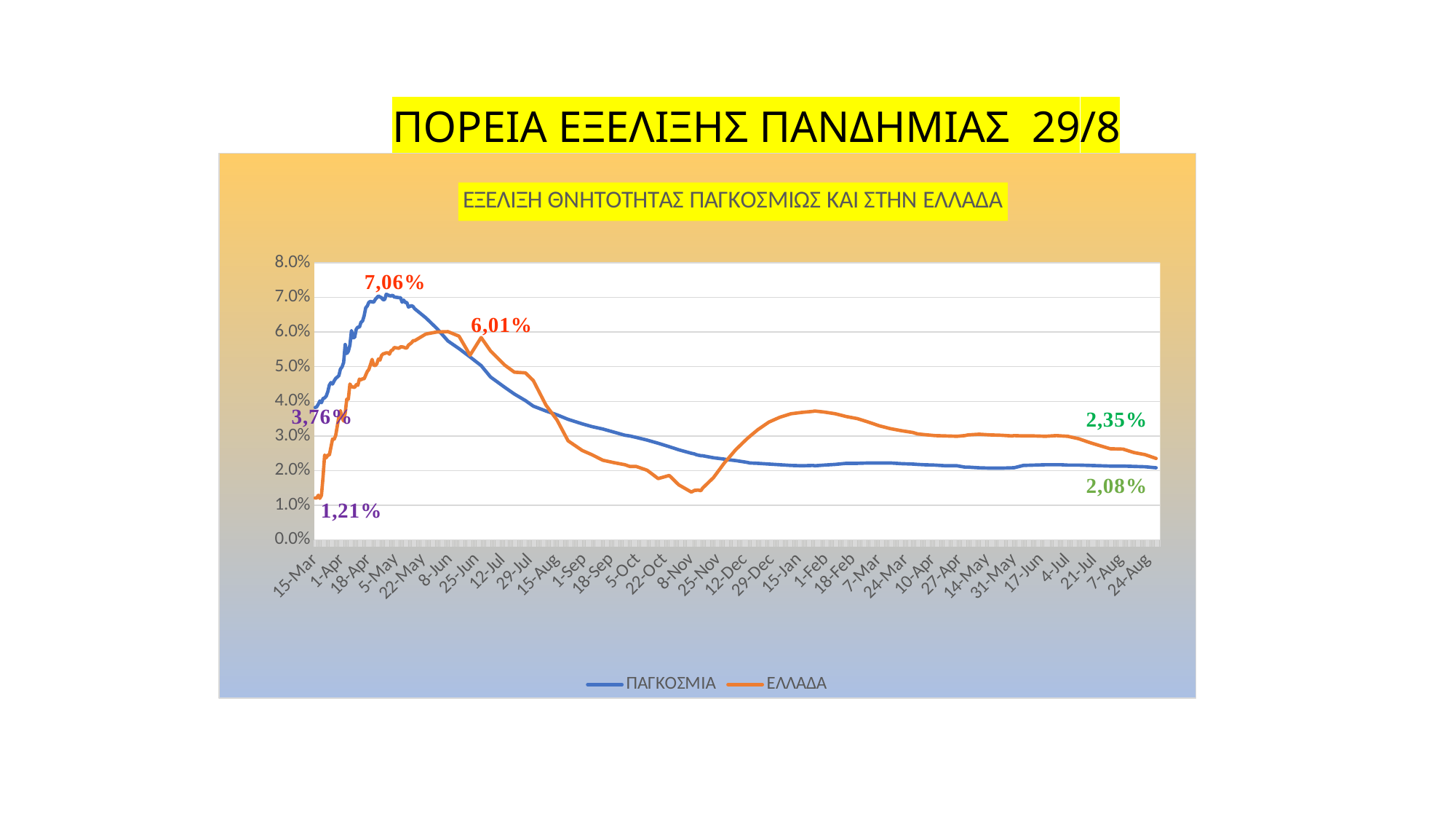
Which series reaches the higher peak value, ΠΑΓΚΟΣΜΙΑ or ΕΛΛΑΔΑ? ΠΑΓΚΟΣΜΙΑ What is the final value labelled for the ΕΛΛΑΔΑ series at the right end of the chart? 2,35% What is the difference between the labelled peak of ΠΑΓΚΟΣΜΙΑ (7,06%) and the labelled peak of ΕΛΛΑΔΑ (6,01%)? 1,05% Which series is drawn in orange according to the legend? ΕΛΛΑΔΑ What is the peak value labelled for the ΕΛΛΑΔΑ series? 6,01% Is the value of the ΕΛΛΑΔΑ series around 8-Nov greater or less than 2.0%? less What kind of chart is shown on the slide? line chart What is the starting value labelled for the ΠΑΓΚΟΣΜΙΑ series at 15-Mar? 3,76% How many series does the legend list? 2 What is the peak value labelled for the ΠΑΓΚΟΣΜΙΑ series? 7,06% What is the final value labelled for the ΠΑΓΚΟΣΜΙΑ series at the right end of the chart? 2,08% What is the starting value labelled for the ΕΛΛΑΔΑ series at 15-Mar? 1,21%